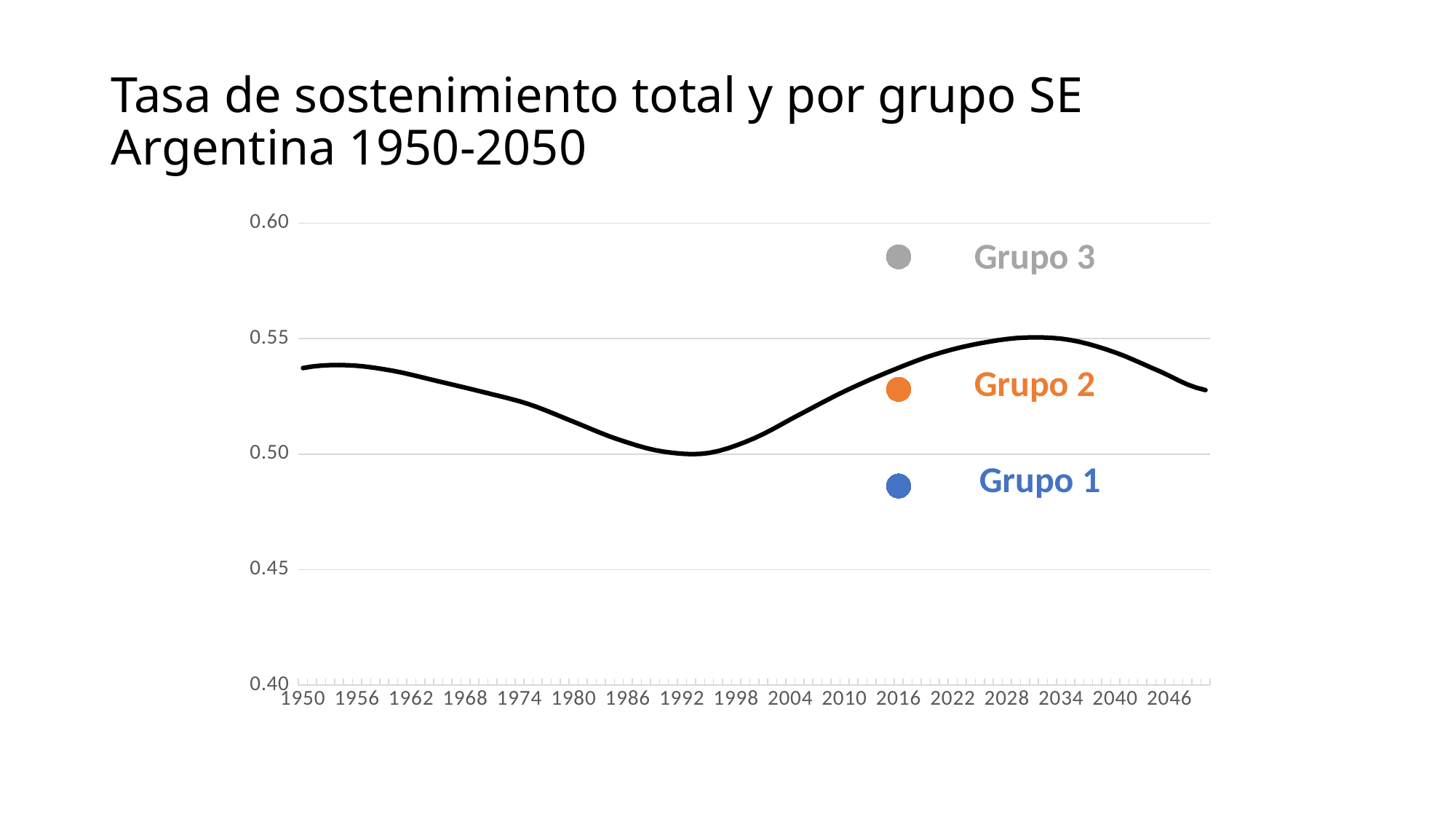
Which group has the lowest value among the three dots? Grupo 1 Is the value for Grupo 2 greater or less than 0.55? less Which group has the highest value among the three dots? Grupo 3 What kind of chart is shown on the slide? line chart Is the value for Grupo 3 greater or less than 0.55? greater What is the title of the chart on the slide? Tasa de sostenimiento total y por grupo SE Argentina 1950-2050 Does the black line rise or fall between 1950 and 1992? fall How many groups (Grupo) are marked with dots on the chart? 3 Does the black line rise or fall between 1992 and 2028? rise Which is larger, the value for Grupo 2 or the value for Grupo 1? Grupo 2 Is the value for Grupo 1 greater or less than 0.50? less